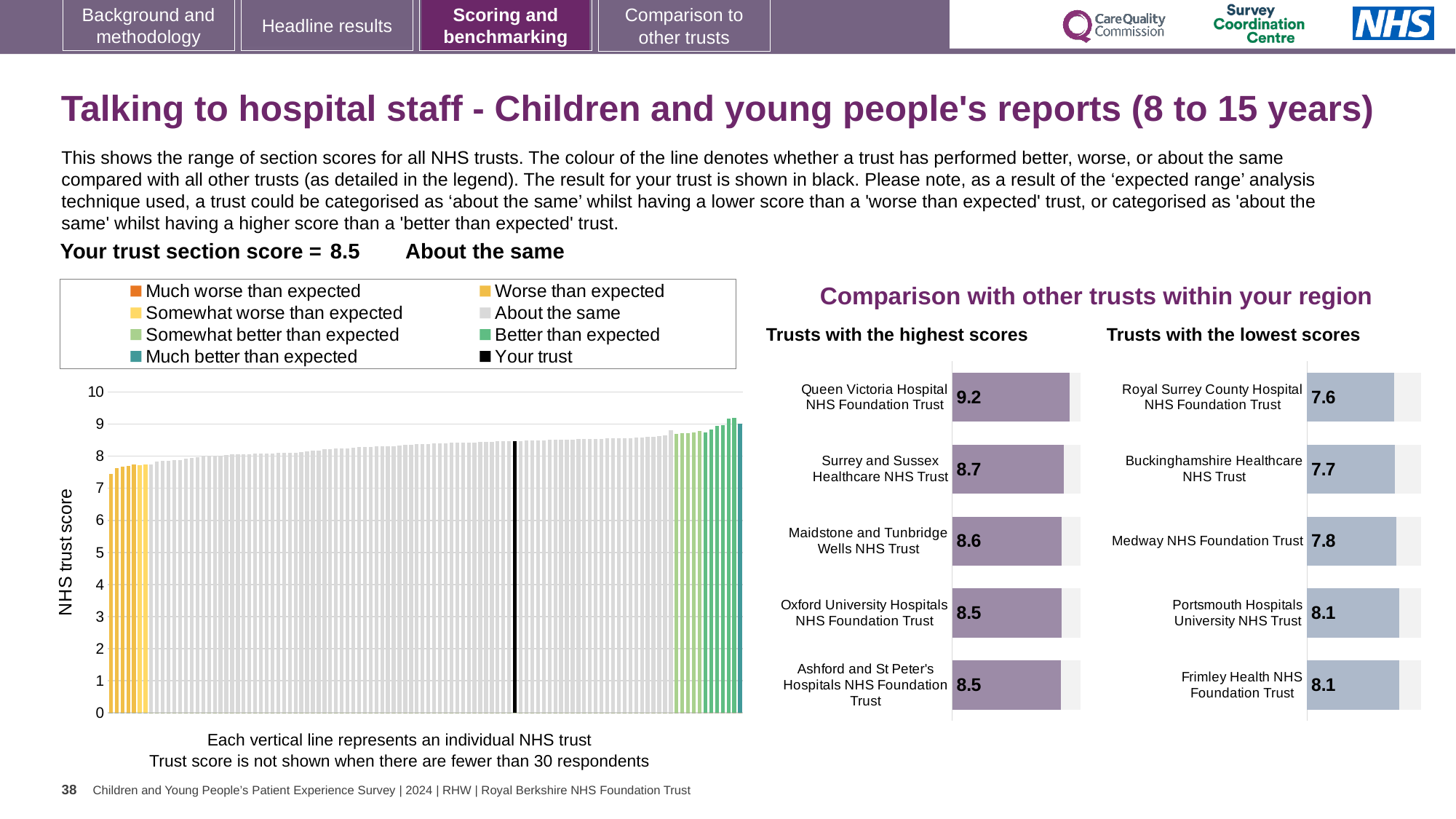
How many entries does the legend of the large chart on the left list? 8 In the 'Trusts with the highest scores' chart, what is the difference between the scores of Queen Victoria Hospital NHS Foundation Trust and Surrey and Sussex Healthcare NHS Trust? 0.5 In the 'Trusts with the lowest scores' chart, which trust has the lowest score? Royal Surrey County Hospital NHS Foundation Trust In the 'Trusts with the highest scores' chart, which trust has the highest score? Queen Victoria Hospital NHS Foundation Trust In the 'Trusts with the lowest scores' chart, how much higher is Portsmouth Hospitals University NHS Trust's score than Royal Surrey County Hospital NHS Foundation Trust's? 0.5 What kind of chart is the large chart on the left showing NHS trust scores? Bar chart In the 'Trusts with the highest scores' chart, what is the score for Queen Victoria Hospital NHS Foundation Trust? 9.2 In the large chart on the left, is the value for the black 'Your trust' bar greater or less than 8? greater In the 'Trusts with the lowest scores' chart, what is the score for Medway NHS Foundation Trust? 7.8 How many trusts are shown in the 'Trusts with the highest scores' chart? 5 What is the y-axis label of the large chart on the left? NHS trust score Which has the higher score: Maidstone and Tunbridge Wells NHS Trust in the highest scores chart, or Buckinghamshire Healthcare NHS Trust in the lowest scores chart? Maidstone and Tunbridge Wells NHS Trust